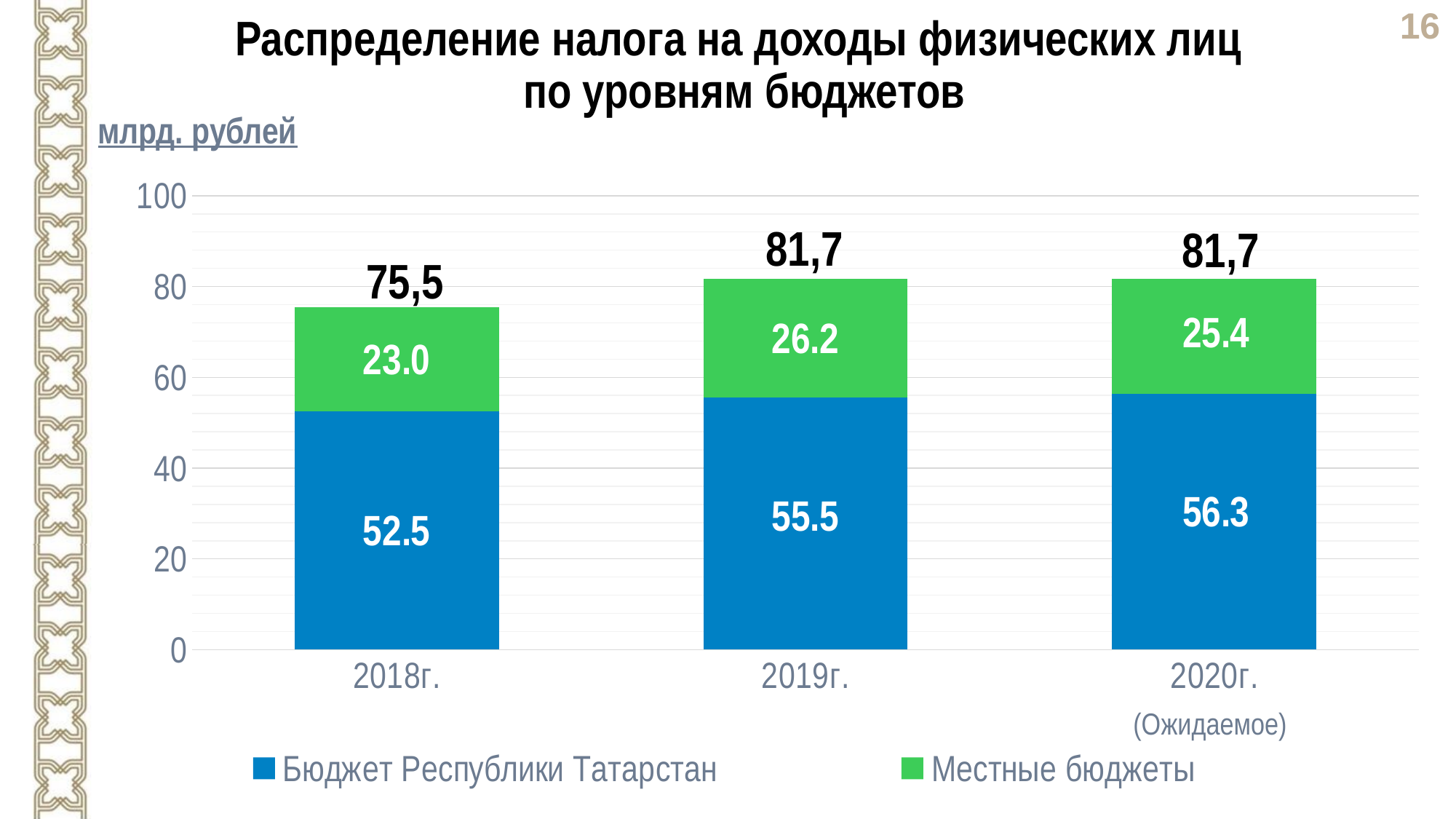
What is the total of the stacked bar for 2019г.? 81,7 What is the value for Местные бюджеты in 2019г.? 26.2 What is the value for Местные бюджеты in 2020г. (Ожидаемое)? 25.4 What is the difference between the Бюджет Республики Татарстан values for 2019г. and 2018г.? 3.0 What is the value for Бюджет Республики Татарстан in 2018г.? 52.5 How many series does the legend list? 2 How many years are shown on the x axis? 3 What is the total of the stacked bar for 2018г.? 75,5 In which year is the value for Бюджет Республики Татарстан lowest? 2018г. In which year is the value for Местные бюджеты highest? 2019г. Which is larger: Местные бюджеты in 2019г. or in 2020г.? 2019г. What kind of chart is shown on the slide? Stacked bar chart